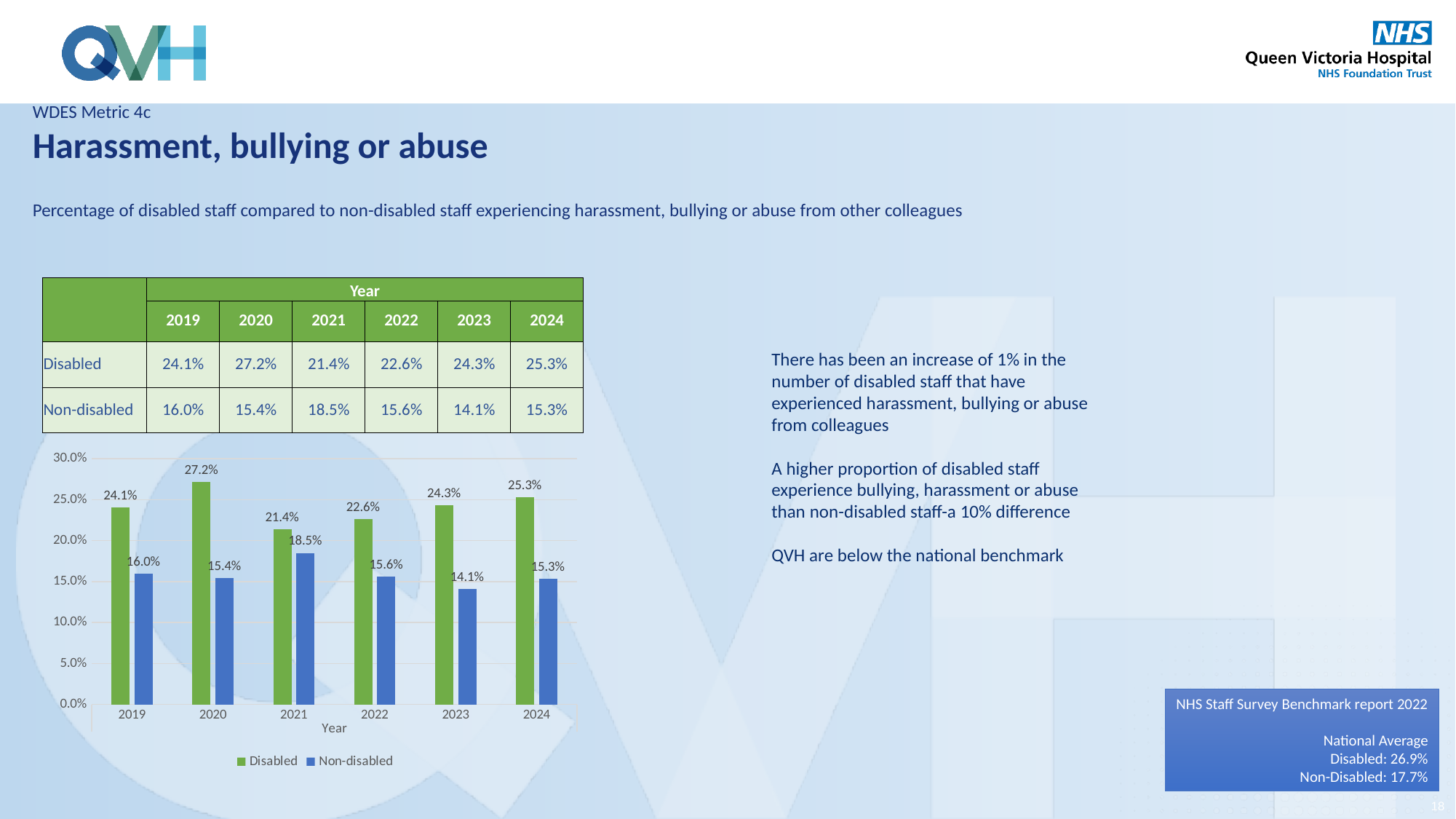
What is the difference between the Disabled and Non-disabled values in 2024? 10.0% How many years are shown on the x axis of the chart? 6 Which is larger in 2021: the Disabled value or the Non-disabled value? Disabled What is the value for Non-disabled staff in 2023? 14.1% What is the value for Disabled staff in 2020? 27.2% Is the Non-disabled value for 2021 greater or less than 15.0%? greater In which year is the Non-disabled series lowest? 2023 What is the value for Disabled staff in 2024? 25.3% Which colour represents the Disabled series in the chart? Green How many series does the chart legend list? 2 In which year is the Disabled series highest? 2020 What kind of chart is shown on the slide? Bar chart